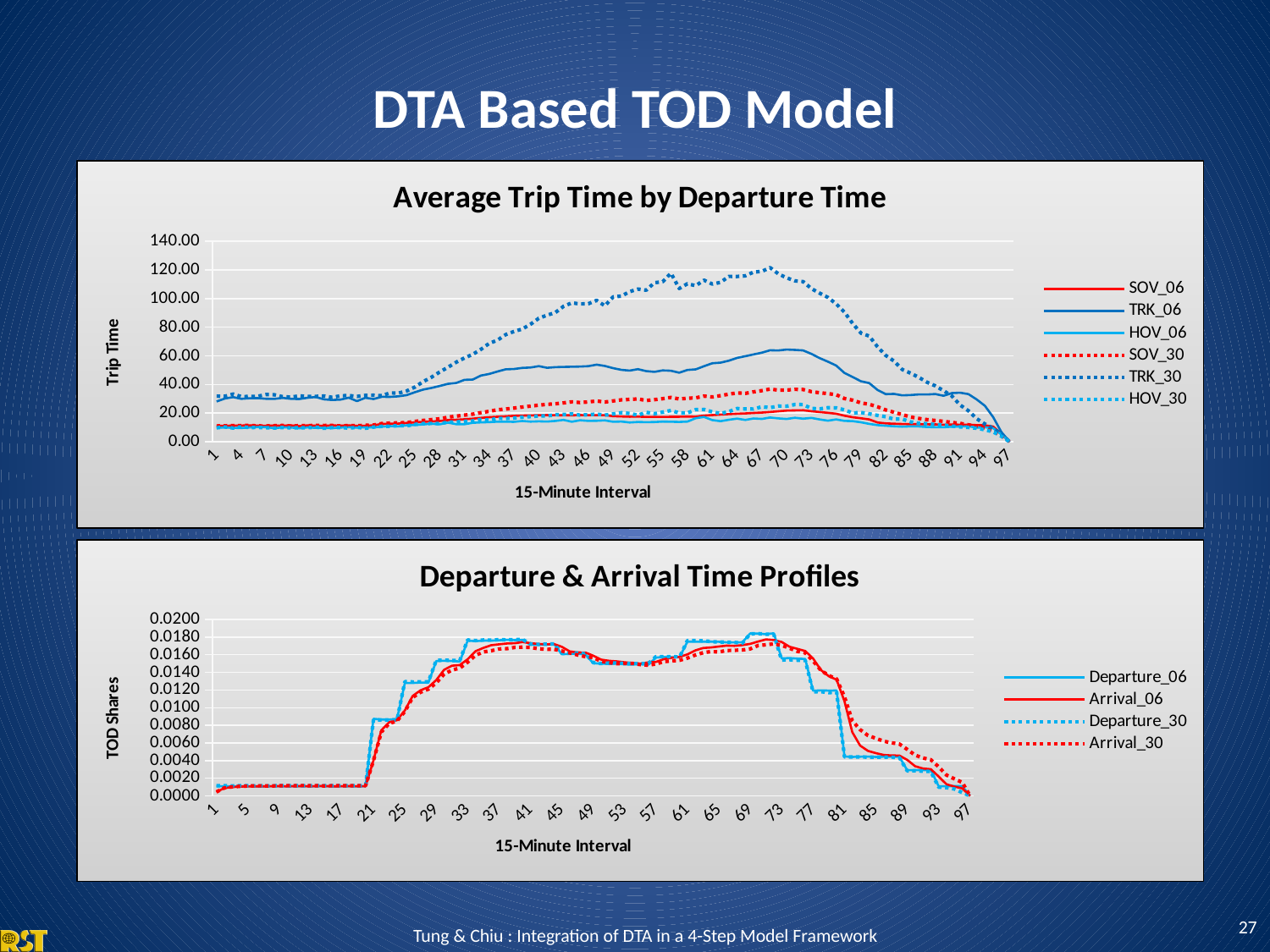
In the 'Departure & Arrival Time Profiles' chart, is the value for Arrival_30 at interval 85 greater or less than 0.0100? less How many series does the legend of the 'Departure & Arrival Time Profiles' chart list? 4 What type of chart is the 'Average Trip Time by Departure Time' chart? Line chart What is the x-axis title of the 'Departure & Arrival Time Profiles' chart? 15-Minute Interval In the 'Average Trip Time by Departure Time' chart, which series reaches the highest trip time? TRK_30 In the 'Average Trip Time by Departure Time' chart, at interval 55, which is larger: TRK_30 or SOV_30? TRK_30 In the 'Departure & Arrival Time Profiles' chart, do the values rise or fall from interval 73 to interval 97? fall In the 'Average Trip Time by Departure Time' chart, is the value for TRK_30 at interval 67 greater or less than 100.00? greater In the 'Departure & Arrival Time Profiles' chart, is the value for Departure_06 at interval 37 greater or less than 0.0160? greater What is the y-axis title of the 'Average Trip Time by Departure Time' chart? Trip Time How many series does the legend of the 'Average Trip Time by Departure Time' chart list? 6